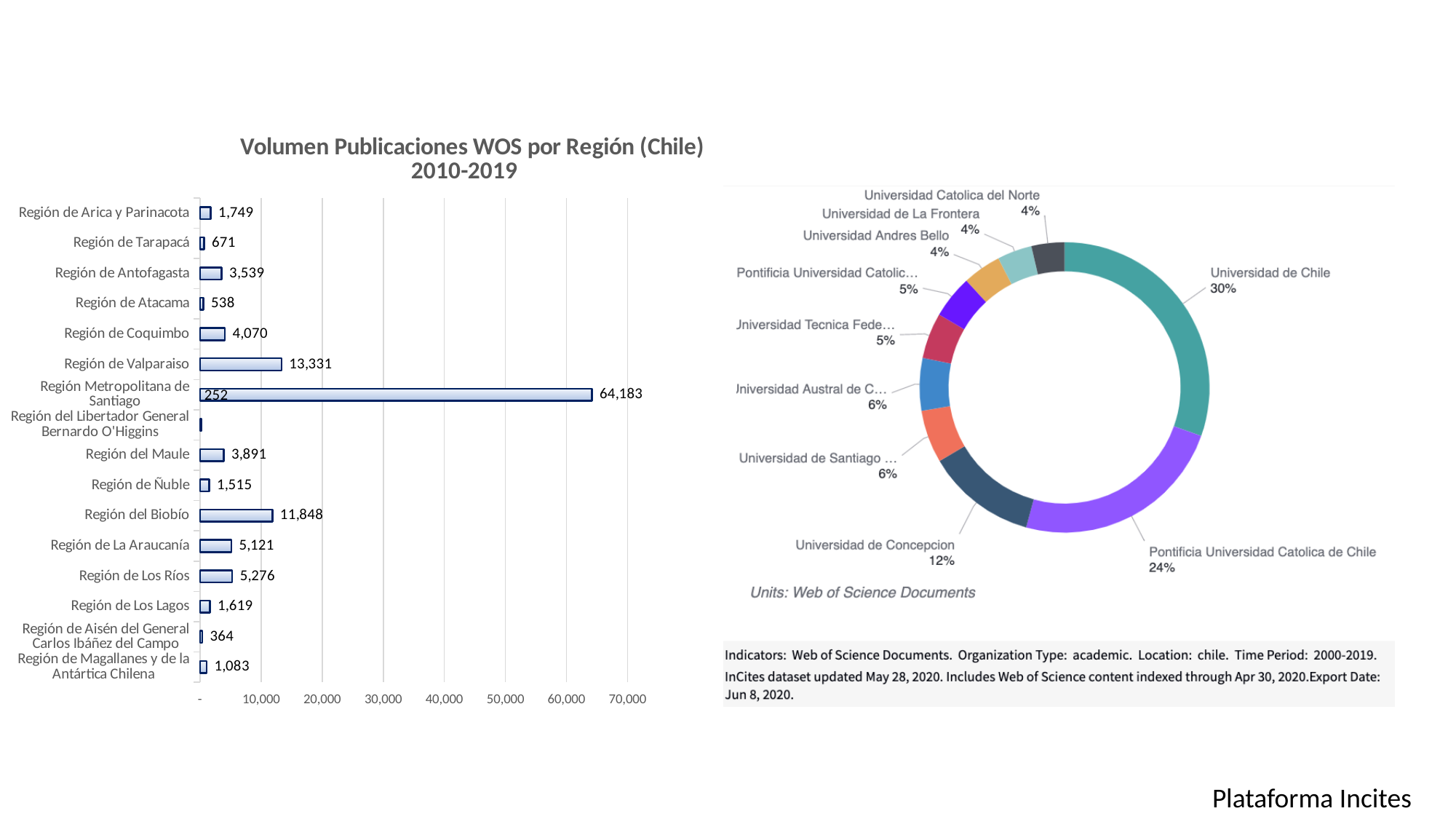
In the bar chart 'Volumen Publicaciones WOS por Región (Chile) 2010-2019', which is larger, Región de Coquimbo or Región del Maule? Región de Coquimbo In the bar chart 'Volumen Publicaciones WOS por Región (Chile) 2010-2019', which region has the lowest value? Región del Libertador General Bernardo O'Higgins In the bar chart 'Volumen Publicaciones WOS por Región (Chile) 2010-2019', what is the value for Región del Biobío? 11,848 In the bar chart 'Volumen Publicaciones WOS por Región (Chile) 2010-2019', is the value for Región Metropolitana de Santiago greater or less than 60,000? greater What kind of chart is the chart on the left of the slide? Bar chart In the donut chart on the right of the slide, which university has the largest share? Universidad de Chile In the bar chart 'Volumen Publicaciones WOS por Región (Chile) 2010-2019', what is the value for Región de Valparaiso? 13,331 In the bar chart 'Volumen Publicaciones WOS por Región (Chile) 2010-2019', which region has the highest value? Región Metropolitana de Santiago In the donut chart on the right of the slide, what are the units stated below the chart? Web of Science Documents How many regions are shown in the bar chart 'Volumen Publicaciones WOS por Región (Chile) 2010-2019'? 16 In the bar chart 'Volumen Publicaciones WOS por Región (Chile) 2010-2019', what is the difference between Región de Los Ríos and Región de La Araucanía? 155 In the donut chart on the right of the slide, what share does Universidad de Chile have? 30%